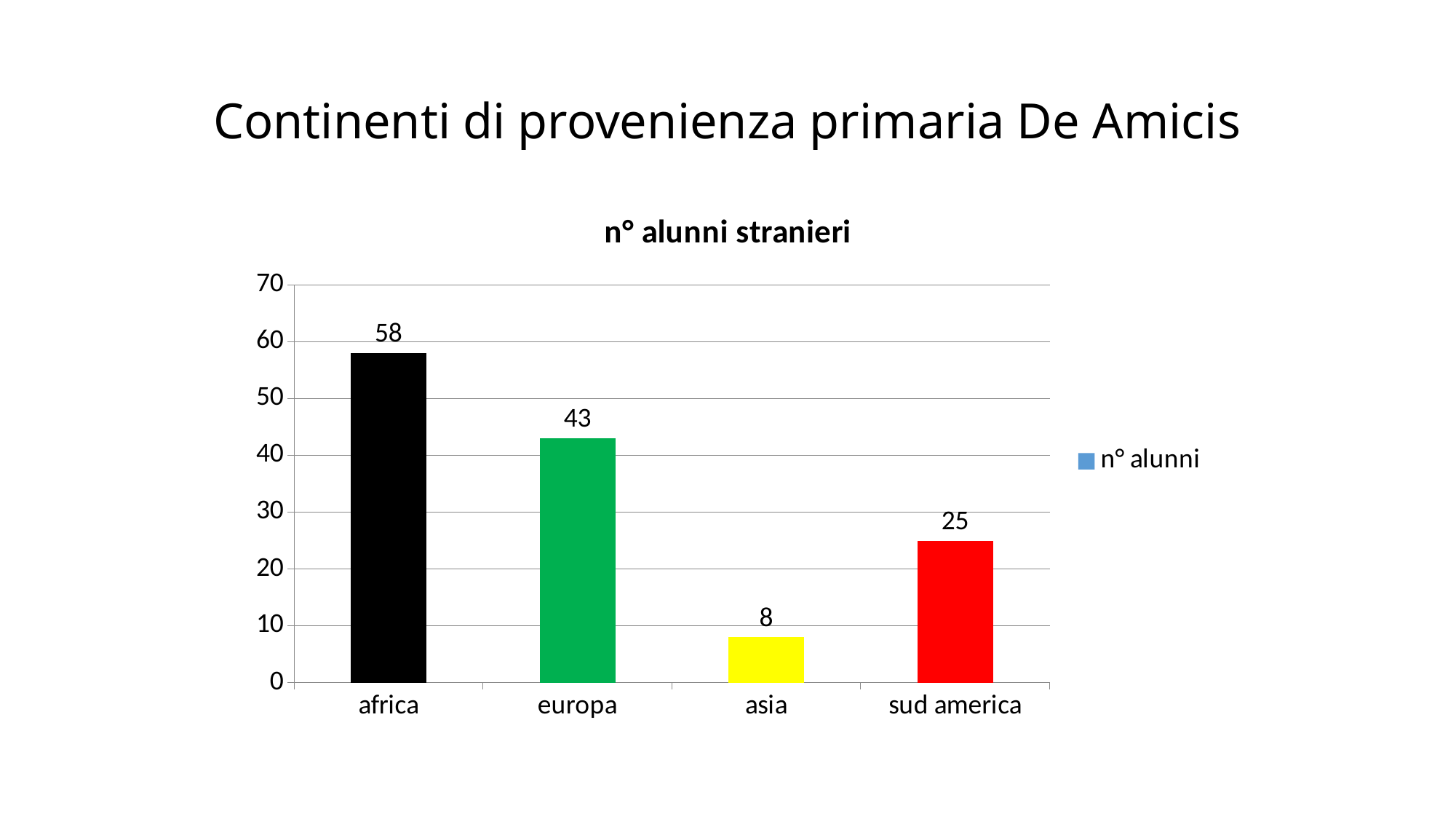
Which category has the lowest value? asia Which category has the highest value? africa How many series does the legend list? 1 Which is larger, the value for europa or the value for sud america? europa What is the value for asia? 8 What kind of chart is shown? bar chart How many categories are shown on the x axis? 4 What is the value for sud america? 25 What is the value for europa? 43 What is the value for africa? 58 What is the difference between the values for africa and europa? 15 What is the title of the chart? n° alunni stranieri